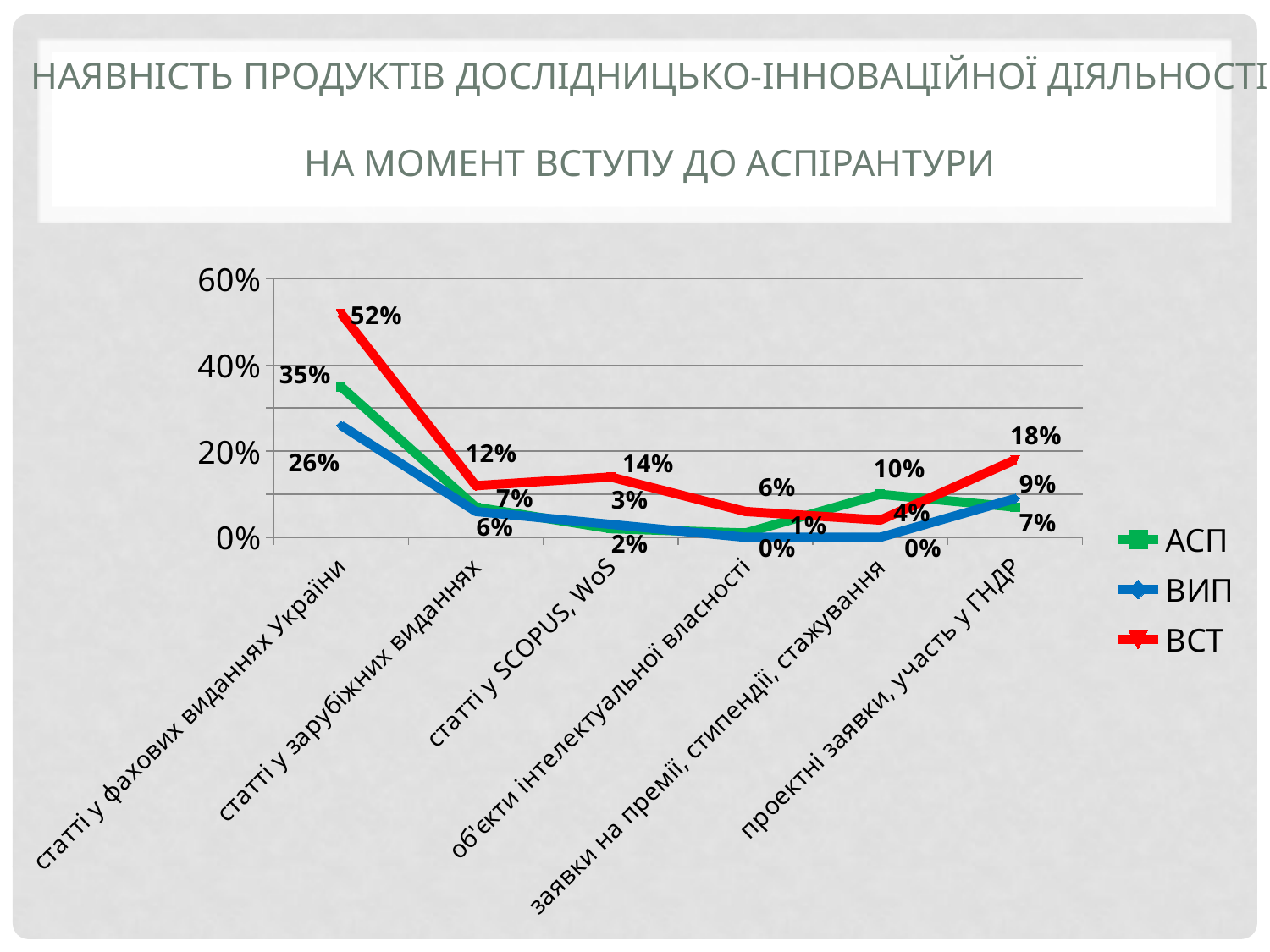
How many series does the legend list? 3 How many categories are plotted along the x axis? 6 What kind of chart is shown on the slide? line chart Which colour represents the ВСТ series in the legend? red What is the value for ВСТ in the category 'статті у SCOPUS, WoS'? 14% In the category 'заявки на премії, стипендії, стажування', which series has the larger value, АСП or ВСТ? АСП What is the value for АСП in the category 'заявки на премії, стипендії, стажування'? 10% What is the value for ВСТ in the category 'статті у фахових виданнях України'? 52% In which category does the ВСТ series reach its highest value? статті у фахових виданнях України What is the difference between the ВСТ and АСП values in the category 'статті у фахових виданнях України'? 17% What is the value for АСП in the category 'статті у фахових виданнях України'? 35% What is the value for ВИП in the category 'проектні заявки, участь у ГНДР'? 9%